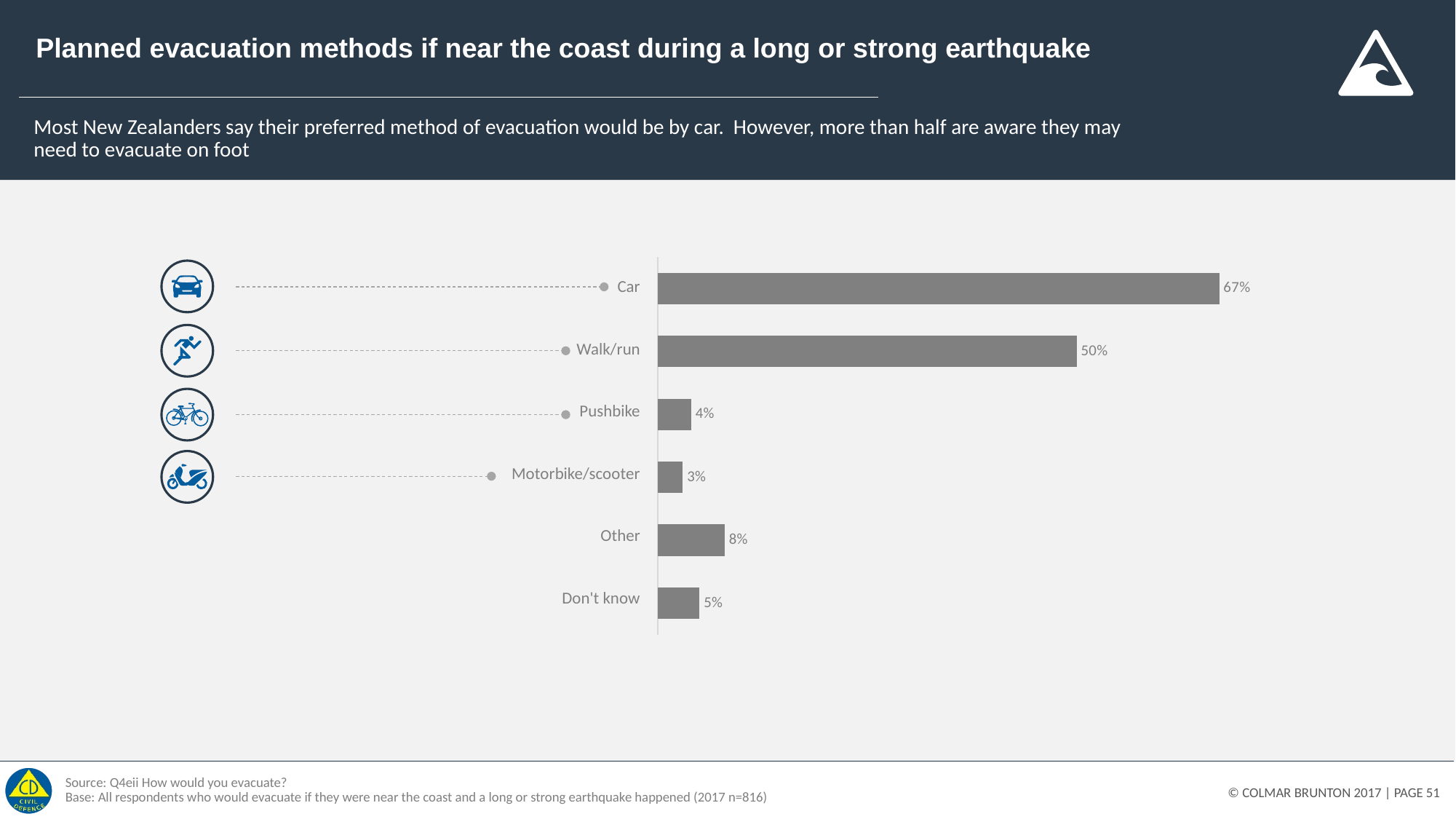
What is the title of the slide? Planned evacuation methods if near the coast during a long or strong earthquake Which evacuation method has the highest percentage? Car How many categories are shown in the chart? 6 What is the value shown for Walk/run? 50% What is the difference in percentage points between Other and Pushbike? 4 Which is larger, the value for Other or the value for Don't know? Other What percentage of respondents say they would evacuate by car? 67% What percentage is shown for Motorbike/scooter? 3% What is the difference in percentage points between Car and Walk/run? 17 What is the value for Don't know? 5% What type of chart is shown on the slide? Bar chart Which evacuation method has the lowest percentage? Motorbike/scooter